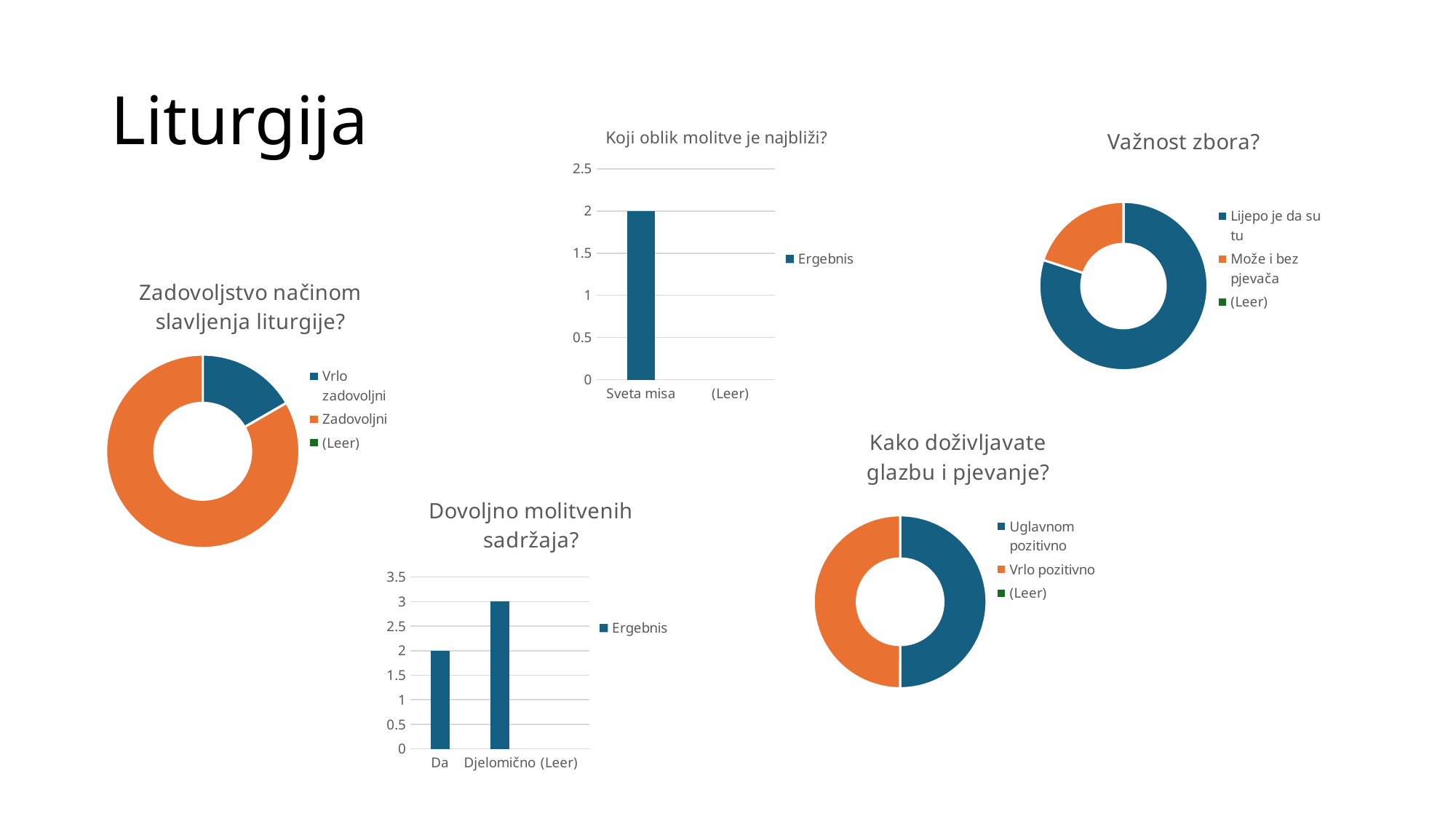
In the chart 'Dovoljno molitvenih sadržaja?', what is the value for Djelomično? 3 What kind of chart is 'Važnost zbora?'? Doughnut chart How many categories are shown on the x axis of the chart 'Dovoljno molitvenih sadržaja?'? 3 How many entries does the legend of the chart 'Kako doživljavate glazbu i pjevanje?' list? 3 In the chart 'Koji oblik molitve je najbliži?', what is the value for Sveta misa? 2 In the chart 'Dovoljno molitvenih sadržaja?', which is larger, the value for Da or the value for Djelomično? Djelomično In the chart 'Dovoljno molitvenih sadržaja?', what is the difference between the values for Djelomično and Da? 1 In the chart 'Dovoljno molitvenih sadržaja?', what is the value for Da? 2 What kind of chart is 'Koji oblik molitve je najbliži?'? Bar chart In the chart 'Važnost zbora?', which is larger, the share for 'Lijepo je da su tu' or 'Može i bez pjevača'? Lijepo je da su tu In the chart 'Zadovoljstvo načinom slavljenja liturgije?', which category has the largest share? Zadovoljni In the chart 'Dovoljno molitvenih sadržaja?', which category has the highest value? Djelomično